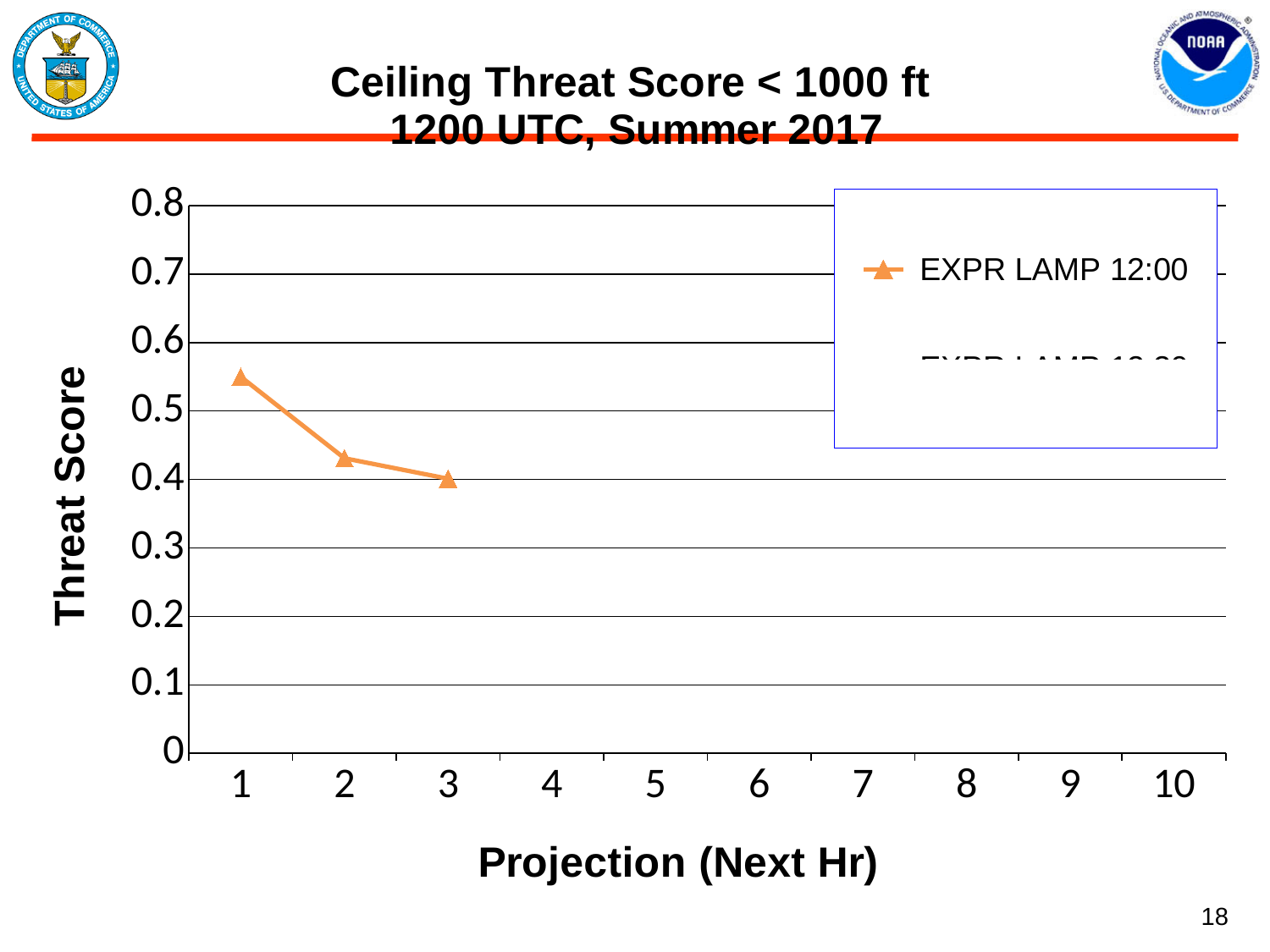
At which projection hour is the EXPR LAMP 12:00 threat score highest? 1 How many data points are plotted for the EXPR LAMP 12:00 series? 3 At which projection hour is the EXPR LAMP 12:00 threat score lowest? 3 Does the threat score for EXPR LAMP 12:00 rise or fall as the projection hour increases? fall What is the title of the chart? Ceiling Threat Score < 1000 ft 1200 UTC, Summer 2017 Is the EXPR LAMP 12:00 threat score at projection 2 greater or less than 0.4? greater What kind of chart is shown on the slide? line chart Is the EXPR LAMP 12:00 threat score at projection 1 greater or less than 0.6? less What is the readable series name in the chart legend? EXPR LAMP 12:00 Is the EXPR LAMP 12:00 threat score at projection 1 greater or less than 0.5? greater Which has the larger EXPR LAMP 12:00 threat score, projection 1 or projection 3? projection 1